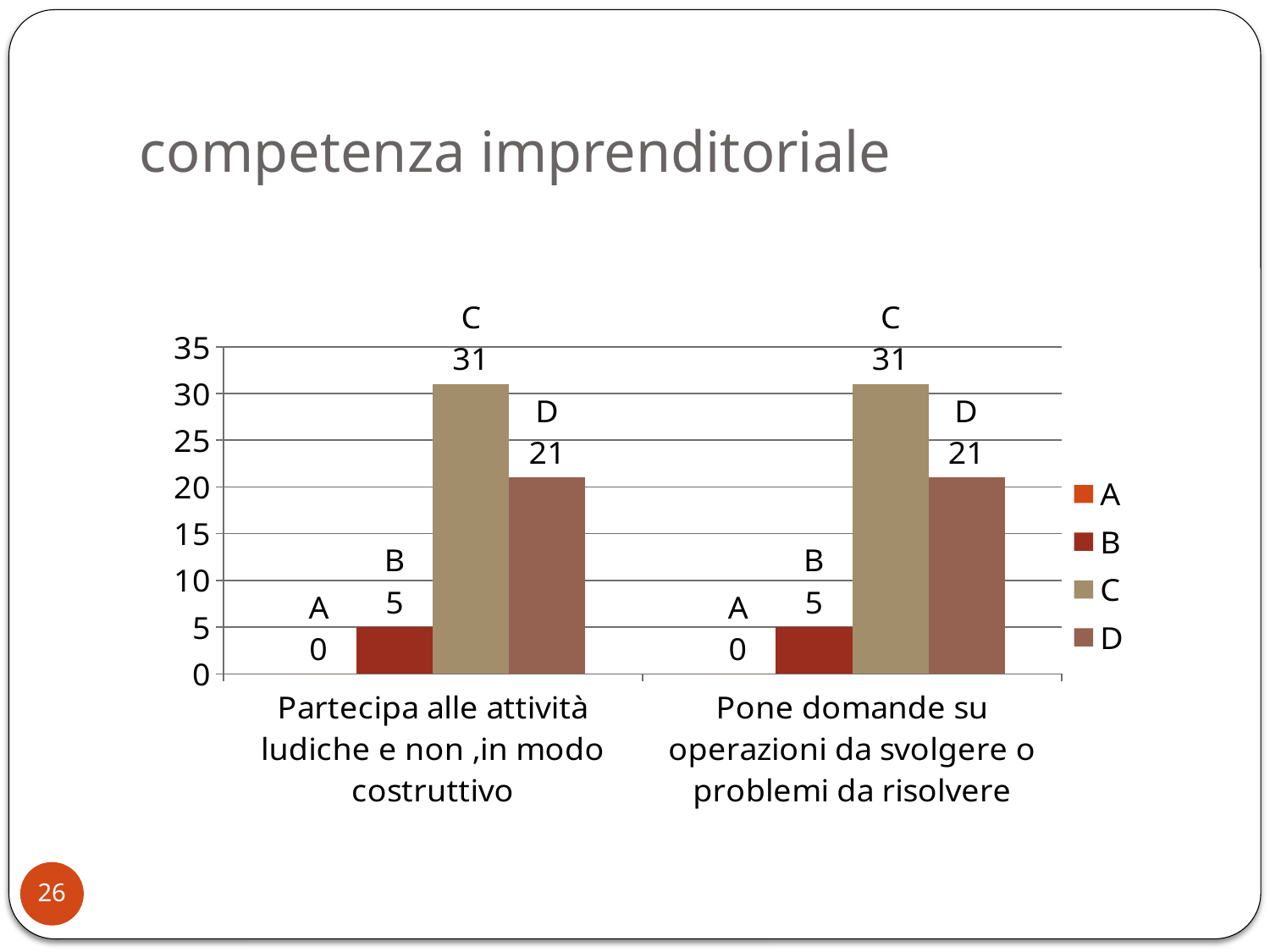
What is the title of the slide? competenza imprenditoriale Which series has the highest value for the category "Pone domande su operazioni da svolgere o problemi da risolvere"? C Which series has the lowest value for the category "Partecipa alle attività ludiche e non ,in modo costruttivo"? A What is the difference between the values of series C and series D for the category "Partecipa alle attività ludiche e non ,in modo costruttivo"? 10 What is the value of series C for the category "Partecipa alle attività ludiche e non ,in modo costruttivo"? 31 What kind of chart is shown on the slide? Bar chart How many categories are shown on the x axis? 2 What is the value of series D for the category "Pone domande su operazioni da svolgere o problemi da risolvere"? 21 What is the value of series B for the category "Partecipa alle attività ludiche e non ,in modo costruttivo"? 5 How many series does the legend list? 4 What is the value of series A for the category "Pone domande su operazioni da svolgere o problemi da risolvere"? 0 For the category "Pone domande su operazioni da svolgere o problemi da risolvere", which is larger: series B or series D? D